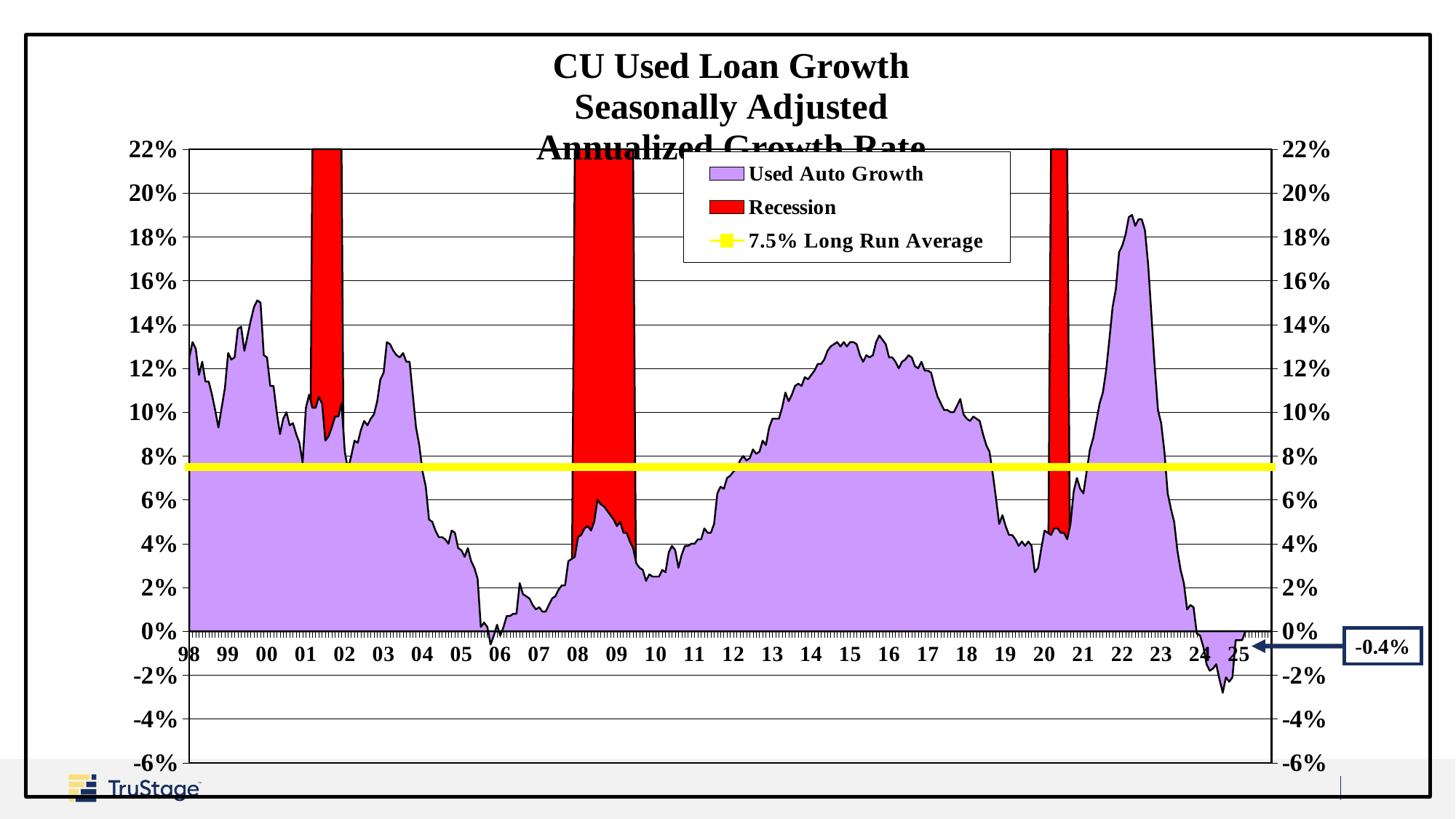
What colour are the recession periods shaded on the chart? Red What value does the long run average line represent? 7.5% Is the value of Used Auto Growth around 2019 greater or less than 6%? less What is the most recent value of Used Auto Growth labeled on the chart? -0.4% How many series does the legend list? 3 Is the value of Used Auto Growth around 2015 greater or less than 10%? greater How many recession periods are shaded on the chart? 3 Which peak is higher: the one around 2000 or the one around 2022? 2022 Do the values of Used Auto Growth rise or fall from the 2022 peak to 2024? fall Is the peak value of Used Auto Growth around 2022 greater or less than 16%? greater What kind of chart is shown on the slide? Area chart